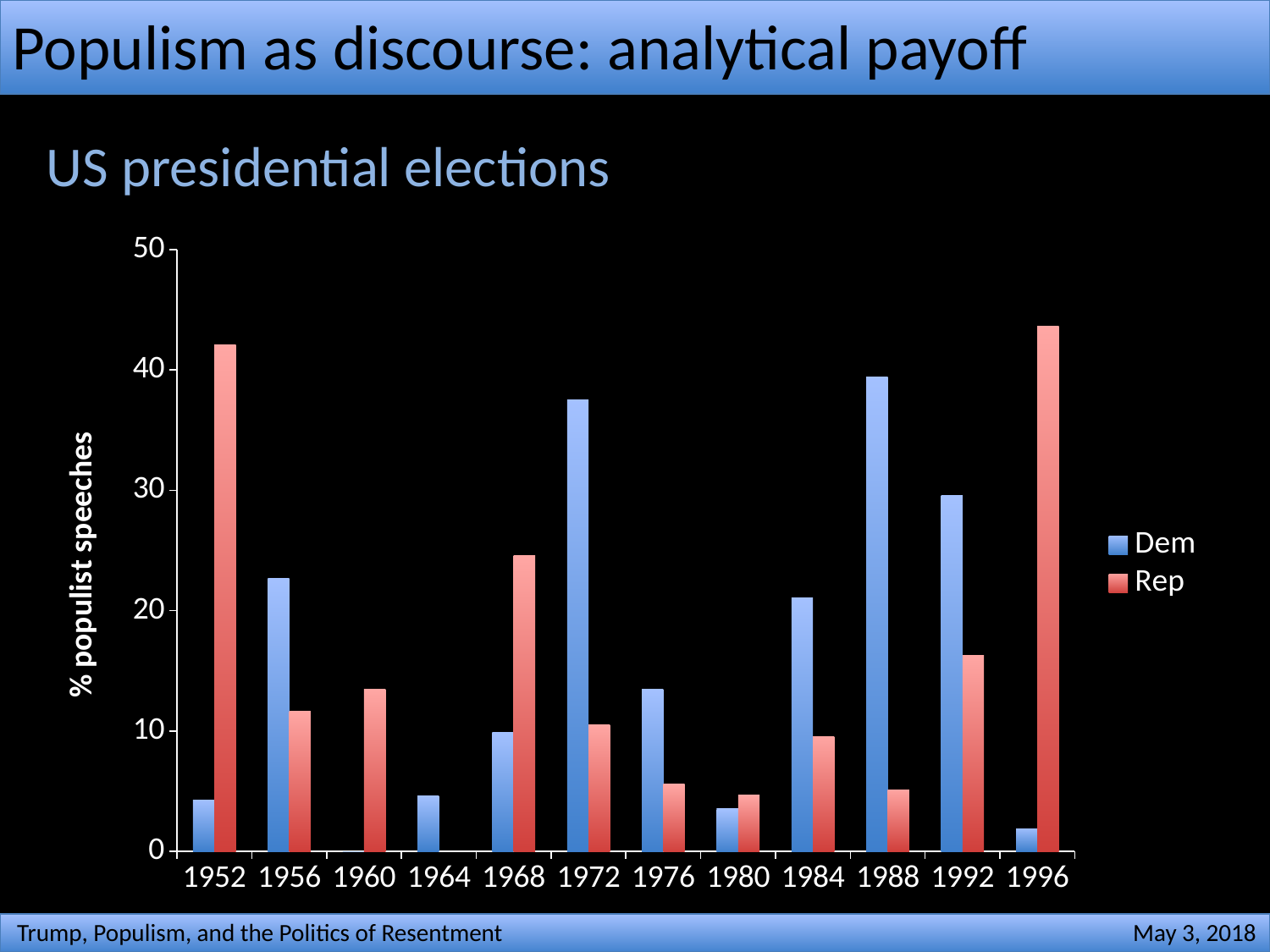
How many election years are shown on the x axis? 12 Is the Dem value for 1972 greater or less than 30? greater How many series does the legend list? 2 In which year is the Dem value highest? 1988 In 1972, which series has the larger value, Dem or Rep? Dem What is the label of the y axis? % populist speeches Is the Dem value for 1996 greater or less than 10? less Is the Rep value for 1952 greater or less than 40? greater Which series is shown in red? Rep What kind of chart is shown on the slide? bar chart